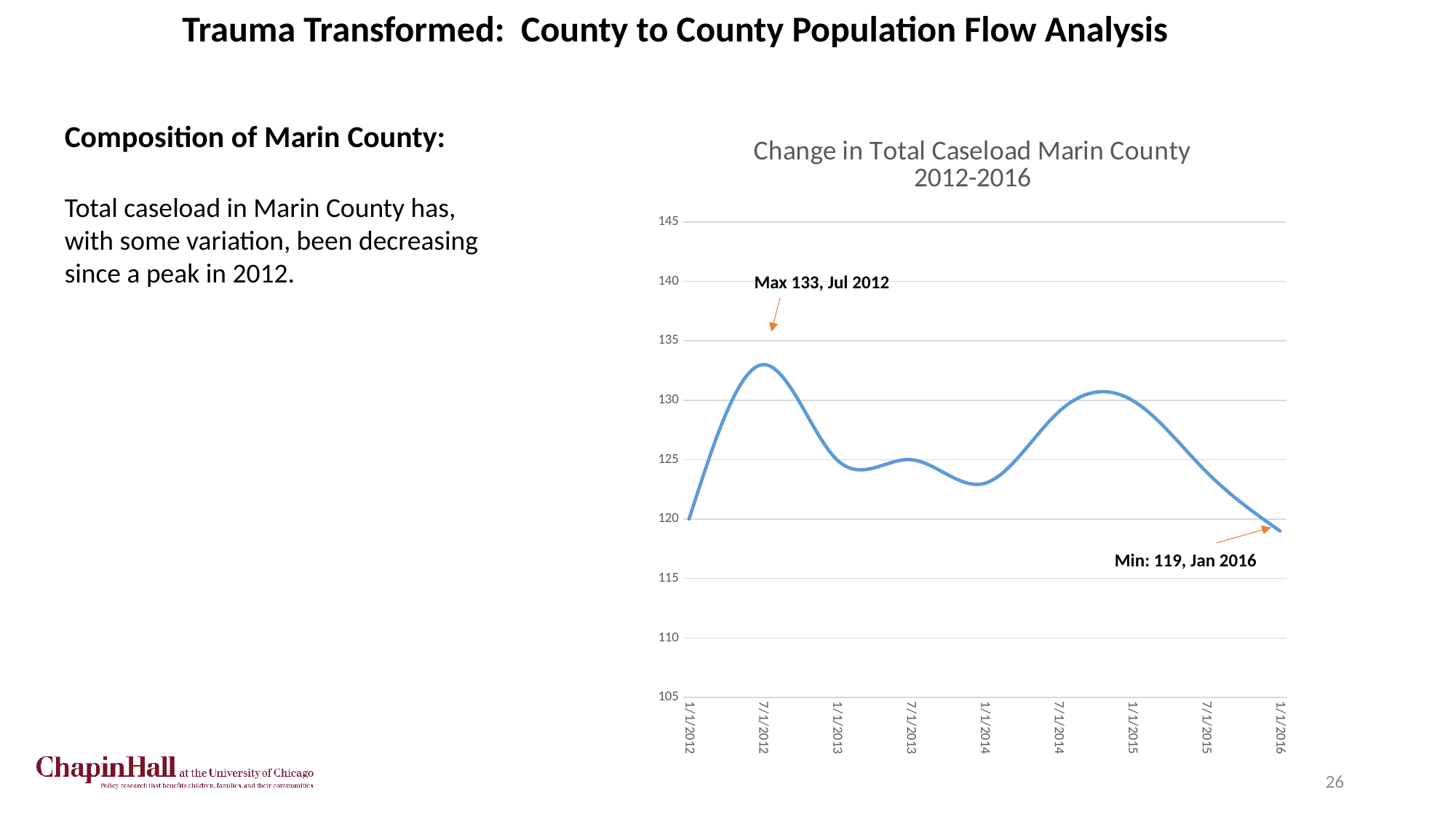
According to the annotation, what is the maximum total caseload shown on the chart? 133 Is the value for 1/1/2015 greater or less than 125? greater According to the annotation, what is the minimum total caseload shown on the chart? 119 In which month does the total caseload reach its minimum? Jan 2016 Is the value for 1/1/2014 greater or less than 125? less How many date labels are shown on the x axis? 9 What is the difference between the annotated maximum and minimum caseload values? 14 What is the title of the chart? Change in Total Caseload Marin County 2012-2016 What kind of chart is shown on the slide? line chart Is the value for 7/1/2014 greater or less than 125? greater In which month does the total caseload reach its maximum? Jul 2012 Does the total caseload rise or fall between 1/1/2015 and 1/1/2016? fall